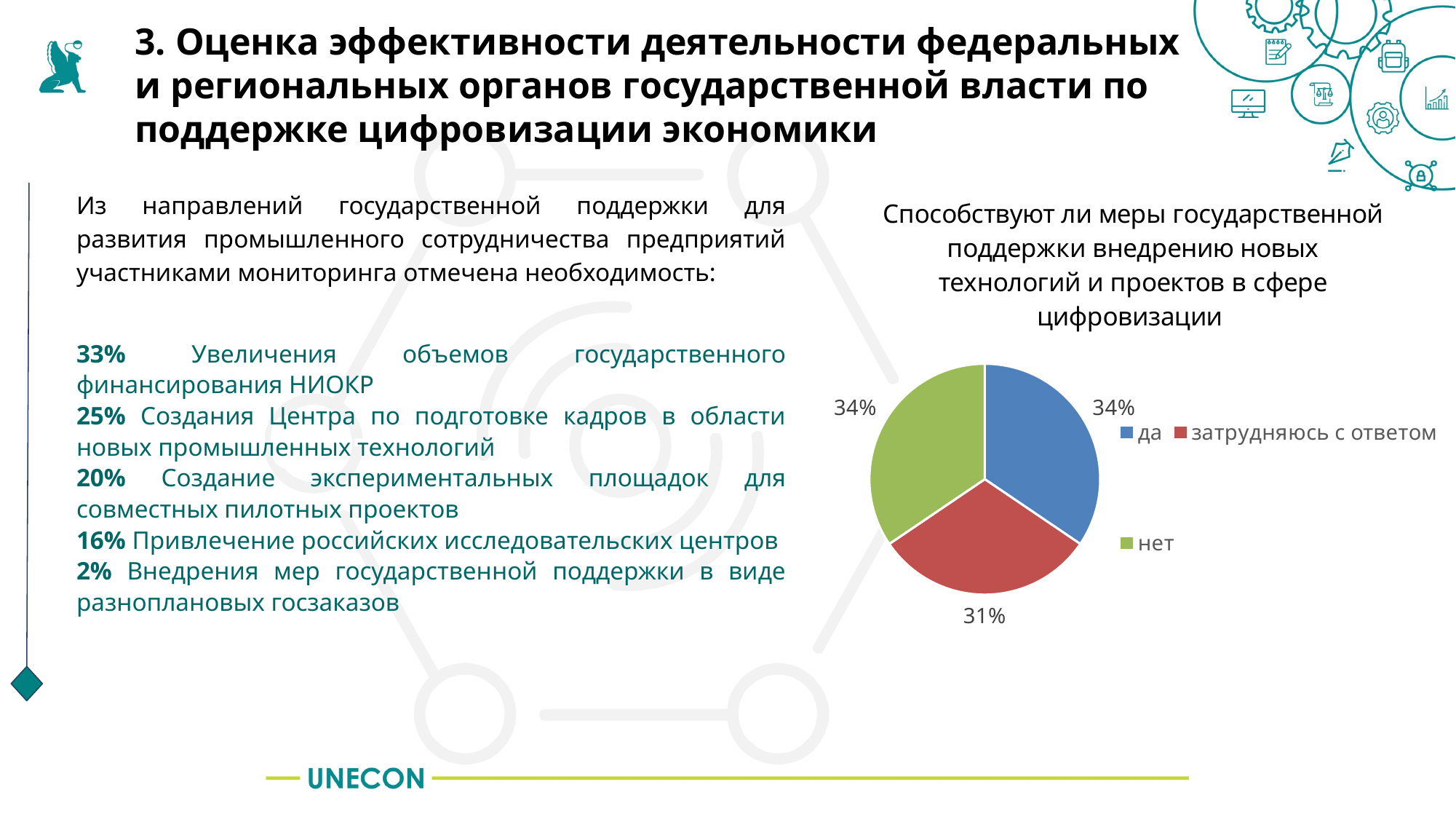
What is the difference in percentage points between the "нет" slice and the "затрудняюсь с ответом" slice? 3 What share of the pie chart is labelled "затрудняюсь с ответом"? 31% What share of the pie chart is labelled "да"? 34% Which is larger in the pie chart, the share for "да" or the share for "затрудняюсь с ответом"? да What is the title of the pie chart? Способствуют ли меры государственной поддержки внедрению новых технологий и проектов в сфере цифровизации Do the "да" and "нет" slices have the same share in the pie chart? yes How many entries does the legend of the pie chart list? 3 What share of the pie chart is labelled "нет"? 34% How many slices does the pie chart have? 3 Which category has the smallest slice in the pie chart? затрудняюсь с ответом What type of chart is shown on the slide? pie chart What colour is the "нет" slice in the pie chart? green